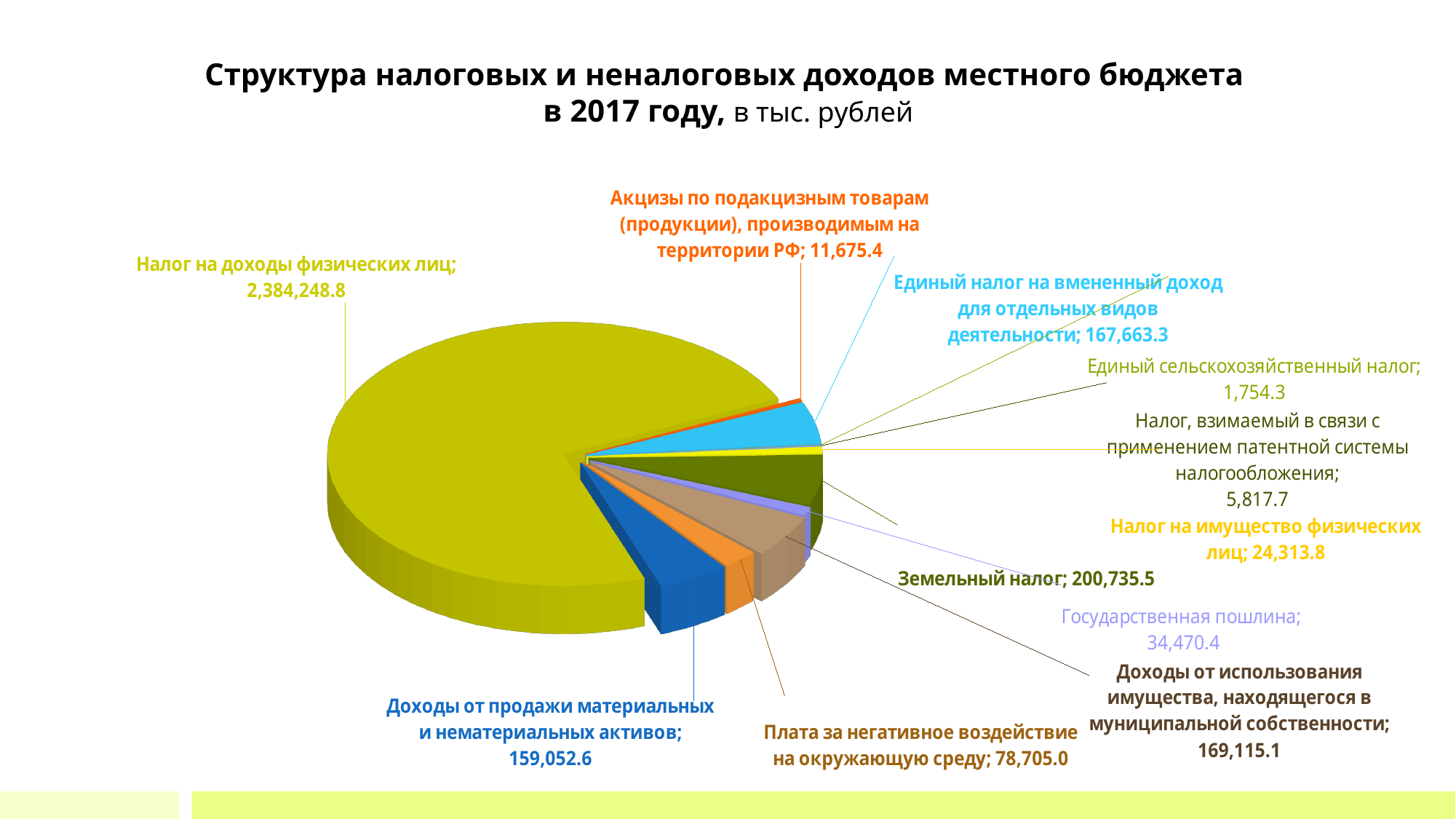
How many categories (slices) does the pie chart have? 11 What kind of chart is shown on the slide? Pie chart What is the difference between Земельный налог and Единый налог на вмененный доход для отдельных видов деятельности? 33,072.2 In what units are the values in the chart expressed, according to the title? тыс. рублей What is the value for Государственная пошлина? 34,470.4 What is the value for Плата за негативное воздействие на окружающую среду? 78,705.0 Which category has the largest value in the pie chart? Налог на доходы физических лиц What is the difference between Государственная пошлина and Налог на имущество физических лиц? 10,156.6 What is the value for Налог на доходы физических лиц? 2,384,248.8 Which category has the smallest value in the pie chart? Единый сельскохозяйственный налог What is the value for Земельный налог? 200,735.5 Which is larger: Доходы от использования имущества, находящегося в муниципальной собственности or Доходы от продажи материальных и нематериальных активов? Доходы от использования имущества, находящегося в муниципальной собственности